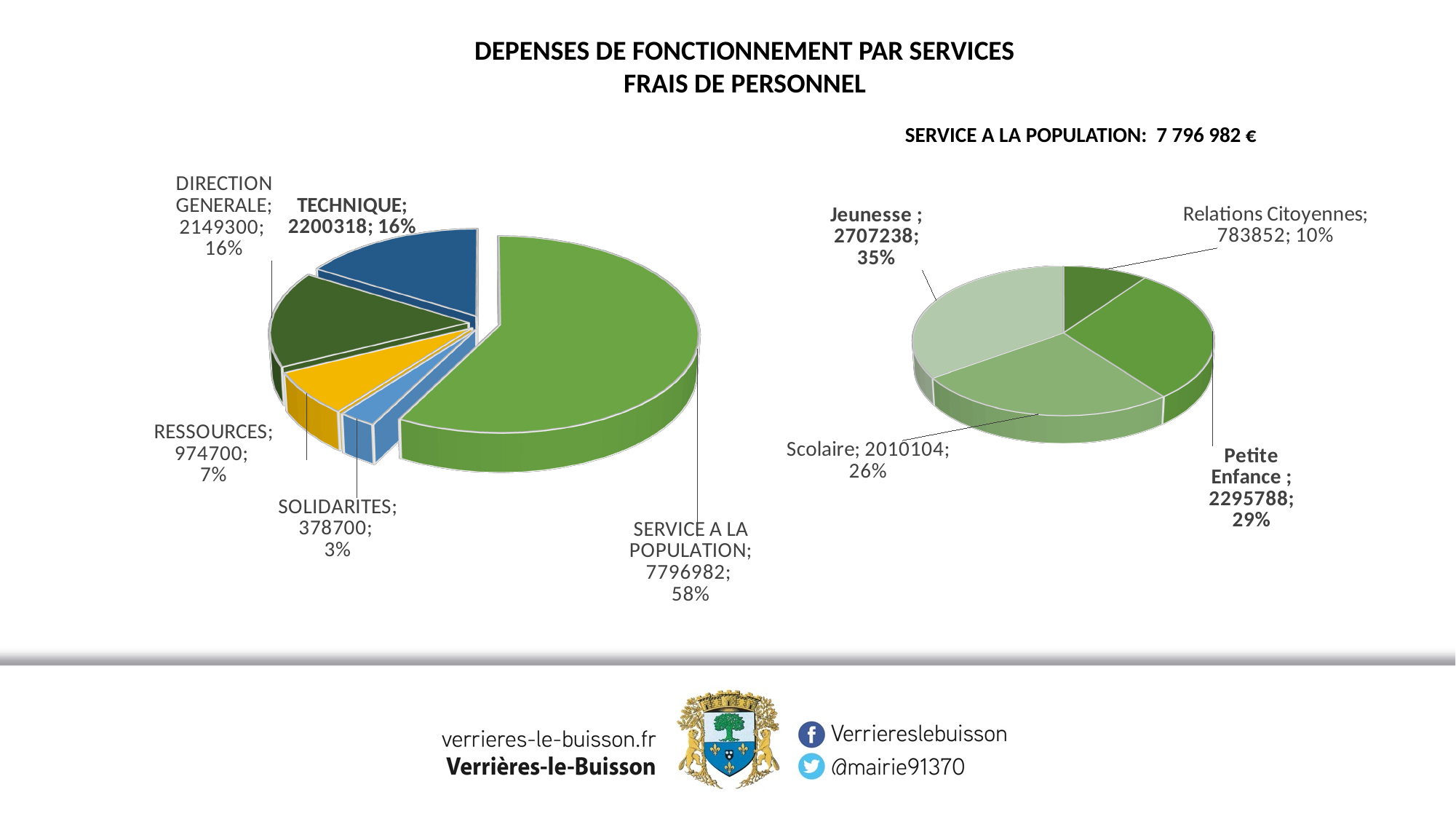
In the right pie chart (SERVICE A LA POPULATION), what is the value for Scolaire? 2010104 In the left pie chart, what share of the pie does RESSOURCES represent? 7% In the right pie chart (SERVICE A LA POPULATION), which is larger, Petite Enfance or Scolaire? Petite Enfance In the left pie chart, what is the value for SERVICE A LA POPULATION? 7796982 How many slices does the left pie chart have? 5 How many slices does the right pie chart (SERVICE A LA POPULATION) have? 4 In the right pie chart (SERVICE A LA POPULATION), which category has the smallest value? Relations Citoyennes In the left pie chart, which category has the smallest value? SOLIDARITES What kind of chart is the left chart on the slide? Pie chart In the left pie chart, what is the difference between the values for TECHNIQUE and DIRECTION GENERALE? 51018 In the left pie chart, which category has the largest value? SERVICE A LA POPULATION In the right pie chart (SERVICE A LA POPULATION), what share of the pie does Jeunesse represent? 35%